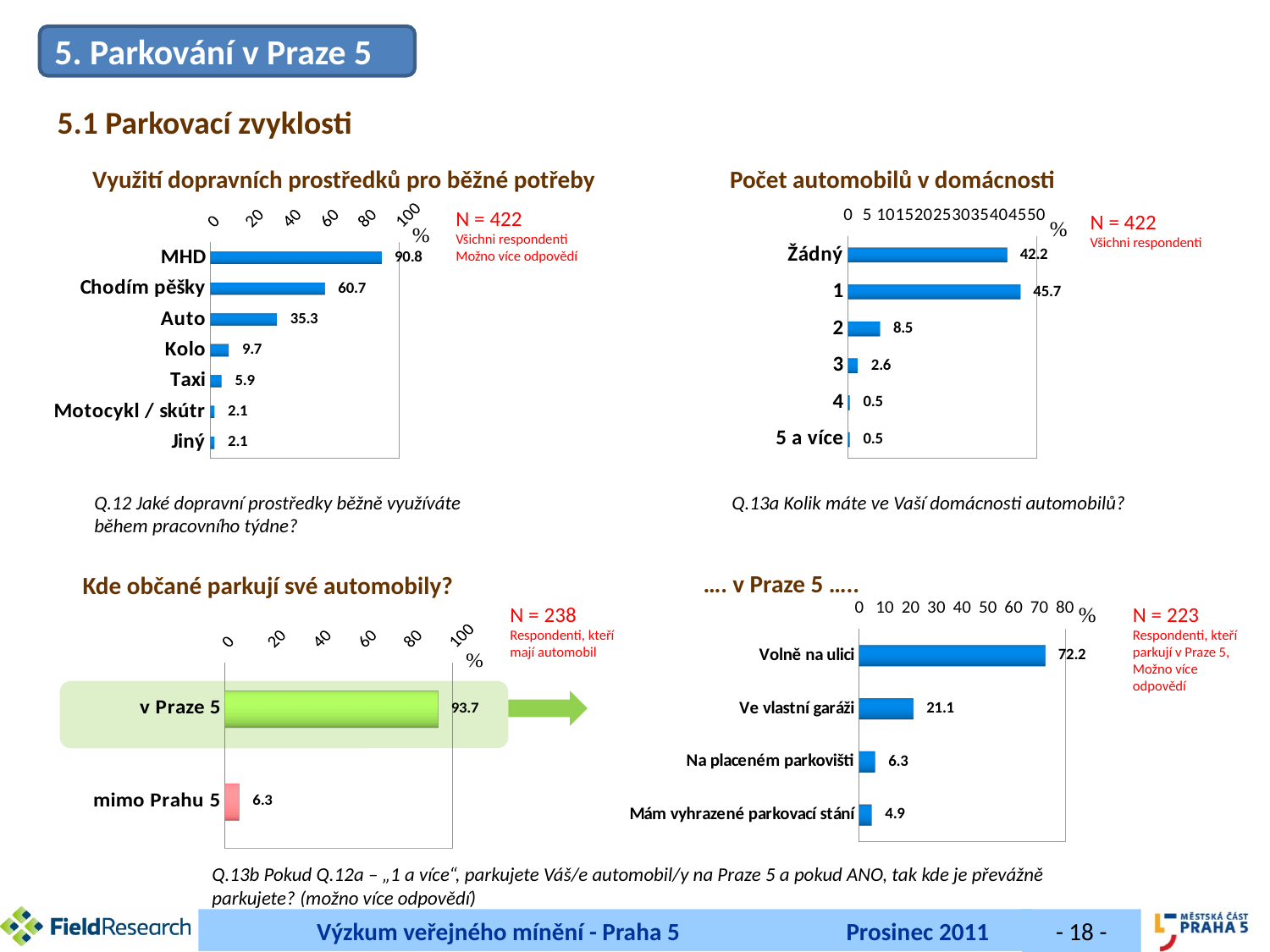
In the chart 'Využití dopravních prostředků pro běžné potřeby', what is the difference between the values for Chodím pěšky and Auto? 25.4 In the chart 'Využití dopravních prostředků pro běžné potřeby', which category has the highest value? MHD In the chart 'Využití dopravních prostředků pro běžné potřeby', what is the value for MHD? 90.8 In the chart 'Počet automobilů v domácnosti', how many categories are shown? 6 In the chart 'Počet automobilů v domácnosti', what is the value for 2? 8.5 In the chart 'Kde občané parkují své automobily?', what is the difference between v Praze 5 and mimo Prahu 5? 87.4 In the chart 'Počet automobilů v domácnosti', which category has the highest value? 1 In the chart 'Kde občané parkují své automobily?', what is the value for v Praze 5? 93.7 In the chart 'Využití dopravních prostředků pro běžné potřeby', how many categories are shown? 7 In the chart 'Počet automobilů v domácnosti', what is the value for Žádný? 42.2 In the chart '…. v Praze 5 …..', which category has the lowest value? Mám vyhrazené parkovací stání In the chart '…. v Praze 5 …..', what is the value for Ve vlastní garáži? 21.1